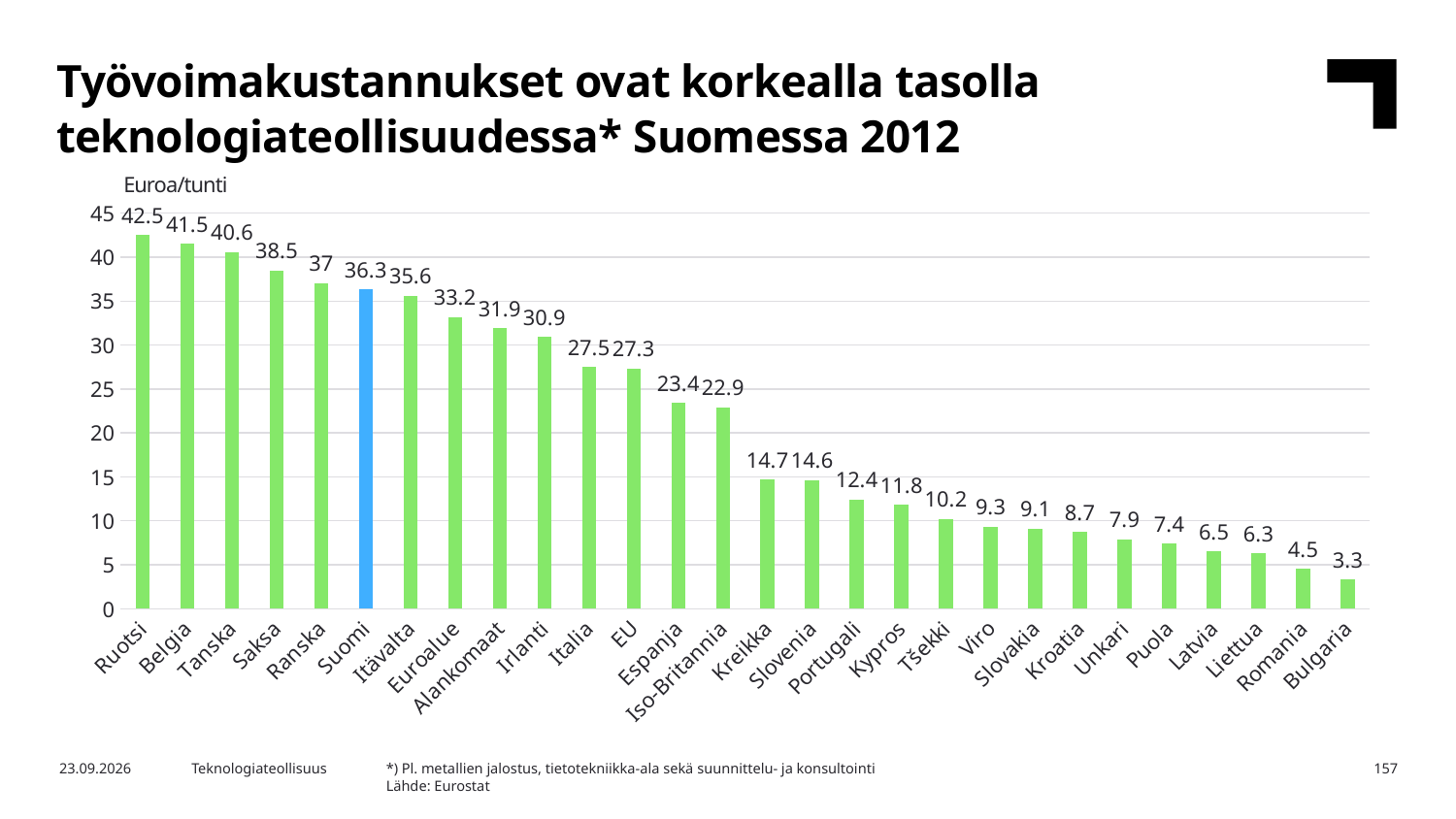
What is the value for Iso-Britannia? 22.9 What is the value for Suomi? 36.3 What is the difference between the values for EU and Bulgaria? 24 How many countries or regions are shown on the chart? 28 Which country has the highest value? Ruotsi Which has a larger value, Saksa or Ranska? Saksa Which country has the lowest value? Bulgaria What kind of chart is shown on the slide? Bar chart Which bar is coloured differently (blue) from the others? Suomi What is the difference between the values for Ruotsi and Suomi? 6.2 Which has a larger value, Espanja or Kreikka? Espanja What is the value for Euroalue? 33.2